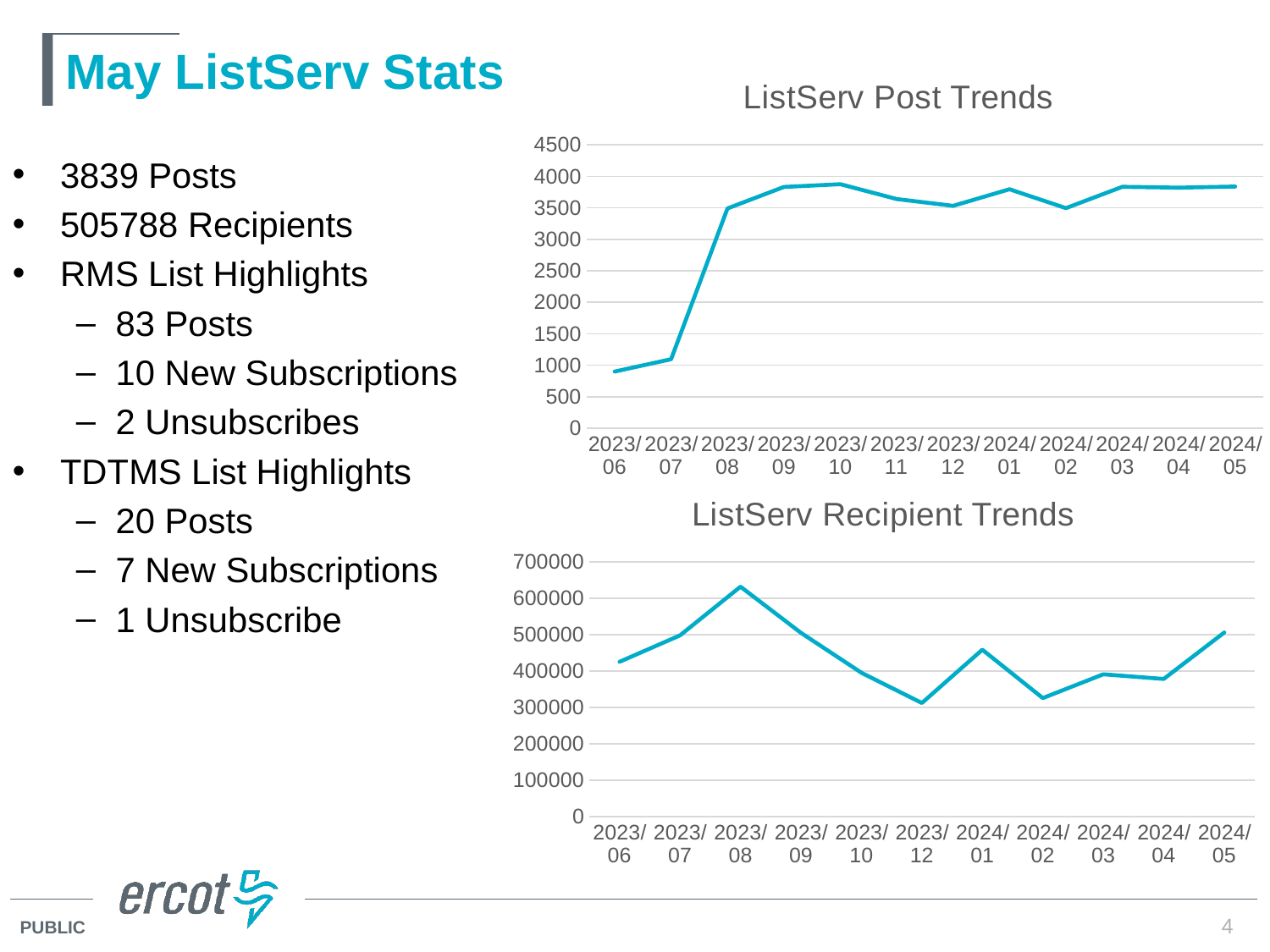
In the "ListServ Post Trends" chart, is the value for 2023/06 greater or less than 1000? less In the "ListServ Recipient Trends" chart, is the value for 2023/08 greater or less than 600000? greater In the "ListServ Post Trends" chart, which is larger, the value for 2023/07 or the value for 2023/09? 2023/09 In the "ListServ Recipient Trends" chart, which is larger, the value for 2023/08 or the value for 2024/02? 2023/08 In the "ListServ Recipient Trends" chart, is the value for 2023/12 greater or less than 400000? less In the "ListServ Post Trends" chart, which month has the lowest value? 2023/06 In the "ListServ Recipient Trends" chart, how many months are plotted on the x axis? 11 In the "ListServ Post Trends" chart, how many months are plotted on the x axis? 12 What kind of chart is the "ListServ Post Trends" chart? line chart What kind of chart is the "ListServ Recipient Trends" chart? line chart In the "ListServ Recipient Trends" chart, which month has the highest value? 2023/08